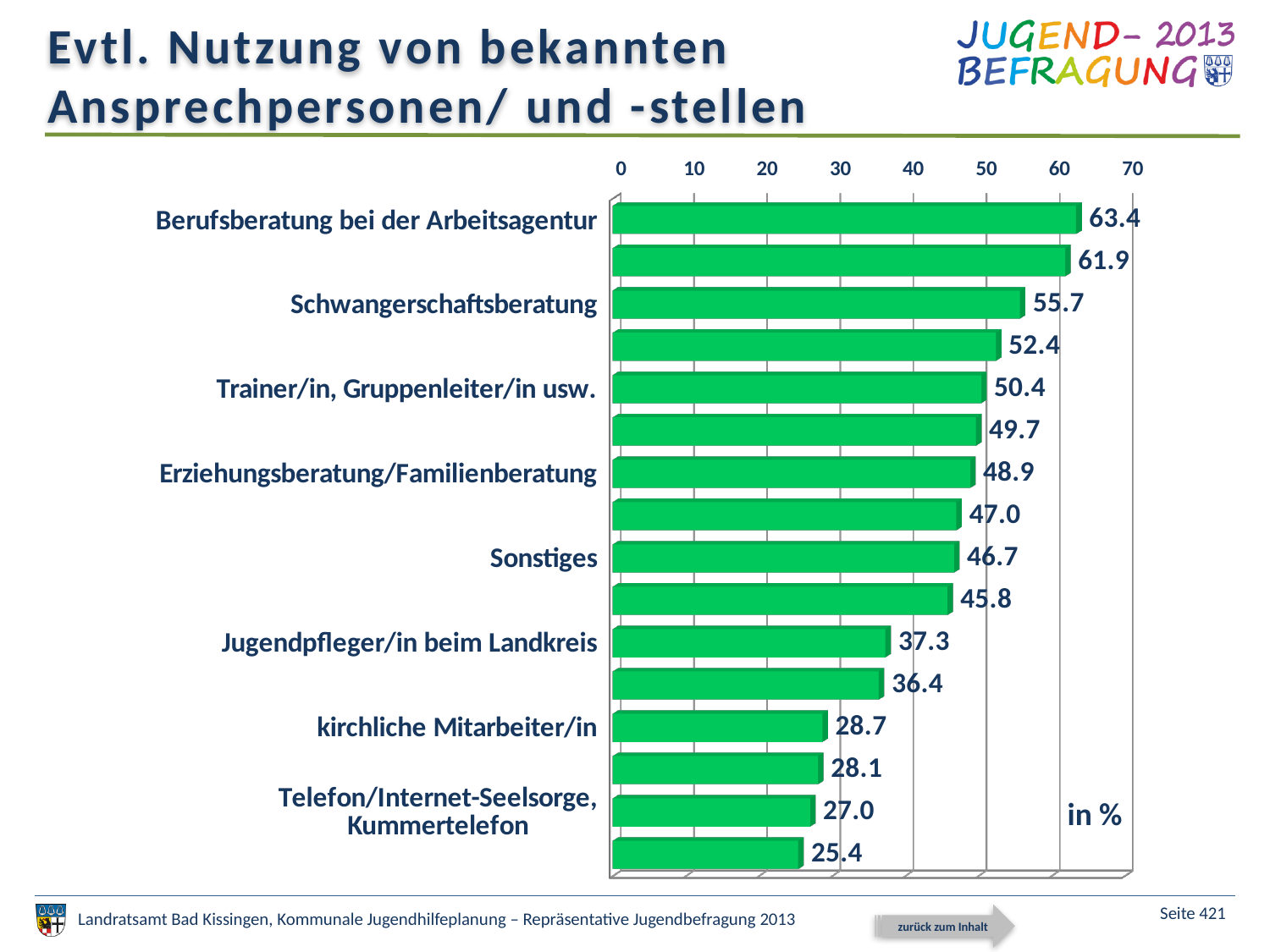
What is the value for kirchliche Mitarbeiter/in? 28.7 Which is larger, the value for Sonstiges or the value for Jugendpfleger/in beim Landkreis? Sonstiges What is the value for Berufsberatung bei der Arbeitsagentur? 63.4 What is the smallest value shown on the chart? 25.4 Which labelled category has the highest value? Berufsberatung bei der Arbeitsagentur What kind of chart is shown on the slide? bar chart Is the value for Erziehungsberatung/Familienberatung greater or less than 50? less What is the value for Schwangerschaftsberatung? 55.7 What is the value for Trainer/in, Gruppenleiter/in usw.? 50.4 What is the difference between the values for Berufsberatung bei der Arbeitsagentur and Schwangerschaftsberatung? 7.7 What is the value for Jugendpfleger/in beim Landkreis? 37.3 In what unit are the values on the chart given? %